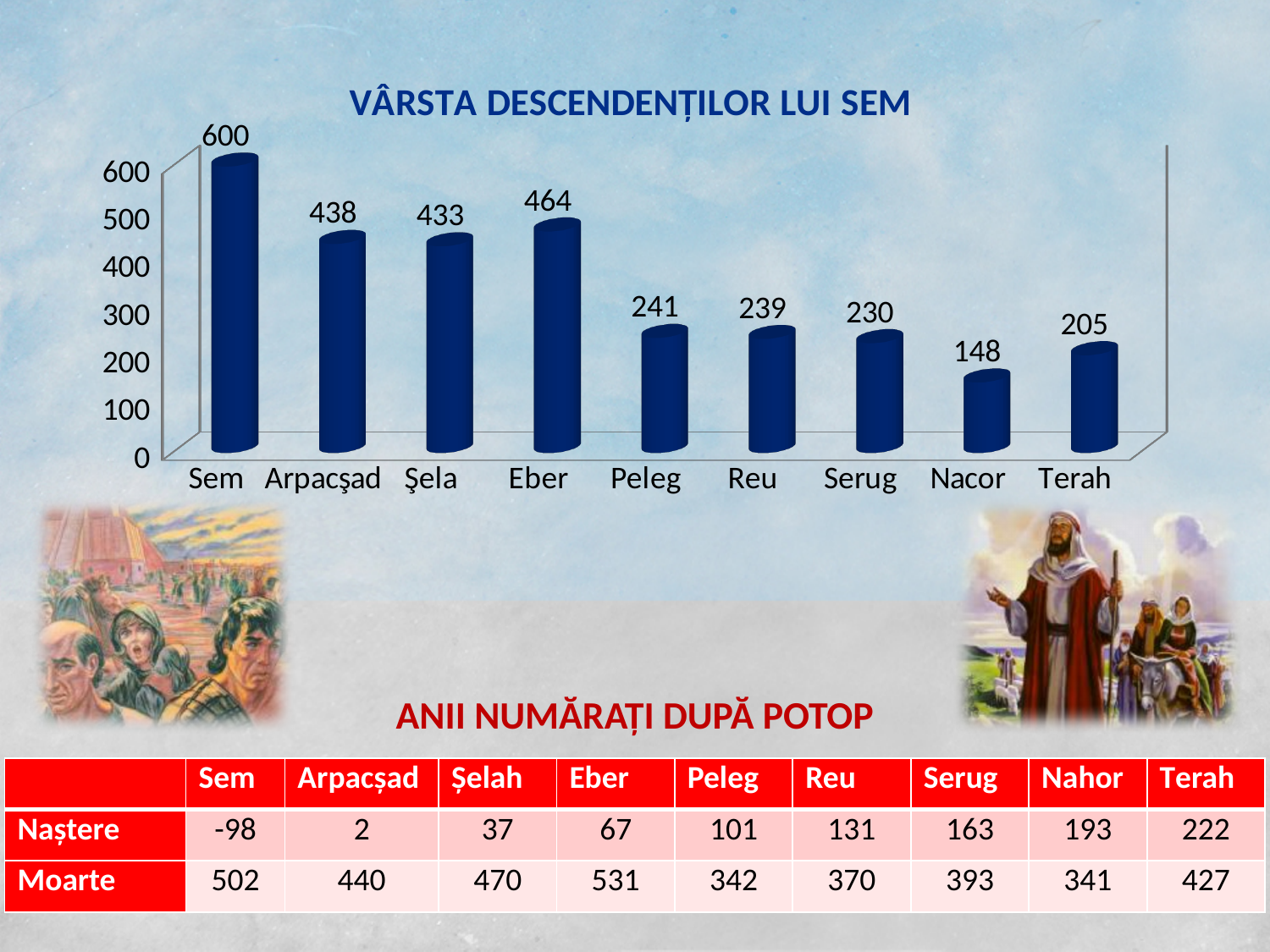
What is the value for Nacor in the chart? 148 What is the difference between the values for Sem and Eber? 136 How many categories are shown in the chart? 9 Which is larger, the value for Eber or the value for Arpacşad? Eber What is the value for Terah in the chart? 205 What is the value for Sem in the chart? 600 What is the title of the chart? VÂRSTA DESCENDENȚILOR LUI SEM What kind of chart is shown on the slide? Bar chart Which category has the highest value in the chart? Sem What is the value for Eber in the chart? 464 What is the difference between the values for Peleg and Nacor? 93 Which category has the lowest value in the chart? Nacor